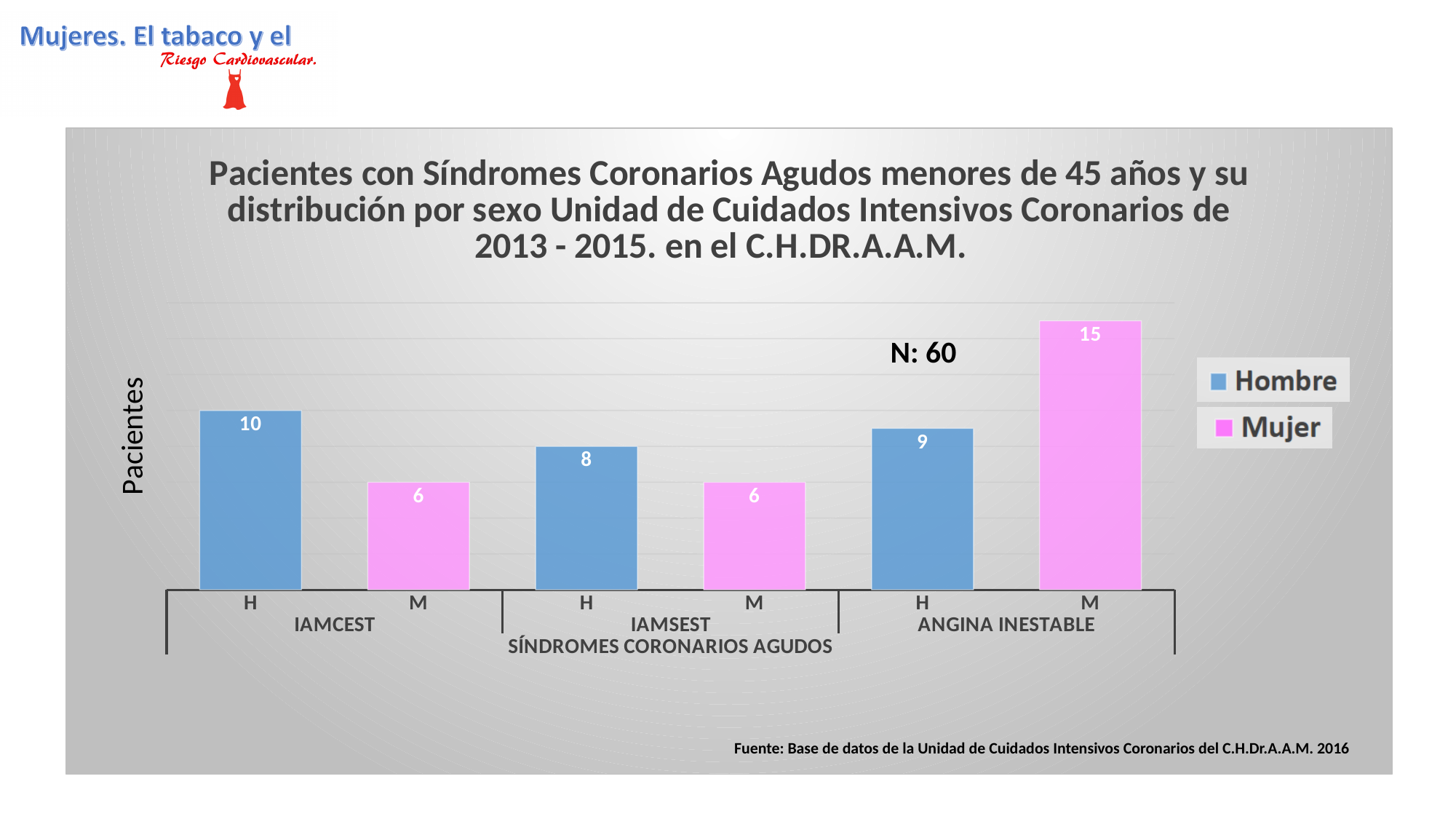
What kind of chart is shown on the slide? Bar chart What colour represents the Mujer series in the legend? Pink How many bars are plotted on the chart? 6 What is the difference between the Mujer and Hombre values in the ANGINA INESTABLE group? 6 What is the N value shown on the chart? 60 What is the value for Hombre (H) in the IAMSEST group? 8 What is the value for Hombre (H) in the IAMCEST group? 10 What is the total of the Hombre and Mujer values in the IAMSEST group? 14 Which is larger in the IAMCEST group, the Hombre value or the Mujer value? Hombre How many series does the legend list? 2 What is the value for Mujer (M) in the ANGINA INESTABLE group? 15 Which bar has the highest value on the chart? M in ANGINA INESTABLE (15)